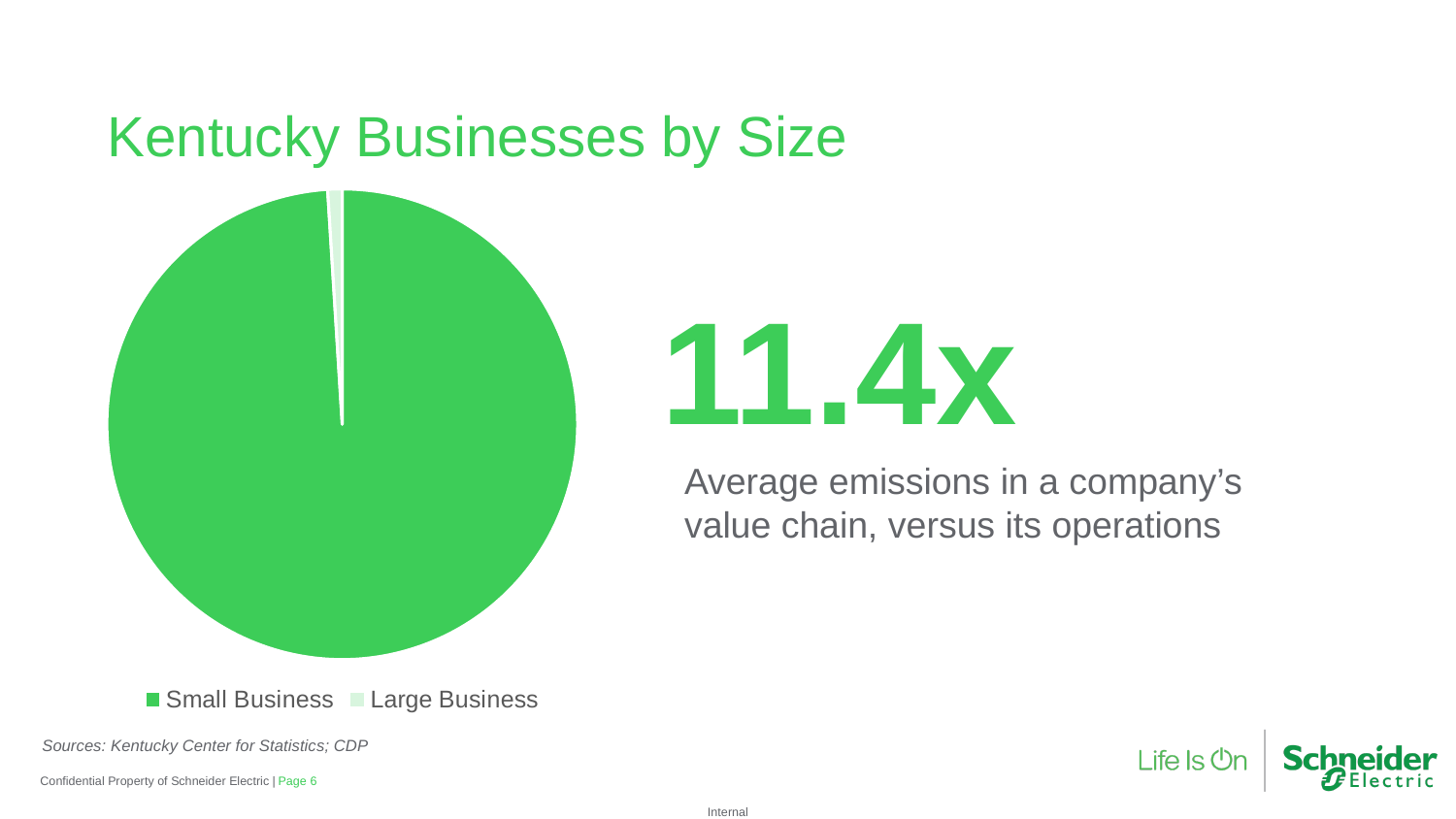
Does the Small Business slice take up more or less than half of the pie chart? More What is the title of the pie chart? Kentucky Businesses by Size How many slices does the pie chart have? 2 Which slice is larger in the pie chart, Small Business or Large Business? Small Business What are the two categories listed in the pie chart's legend? Small Business and Large Business How many entries does the legend of the pie chart list? 2 Which category has the largest slice in the pie chart? Small Business What kind of chart is shown on the slide? Pie chart Which category has the smallest slice in the pie chart? Large Business